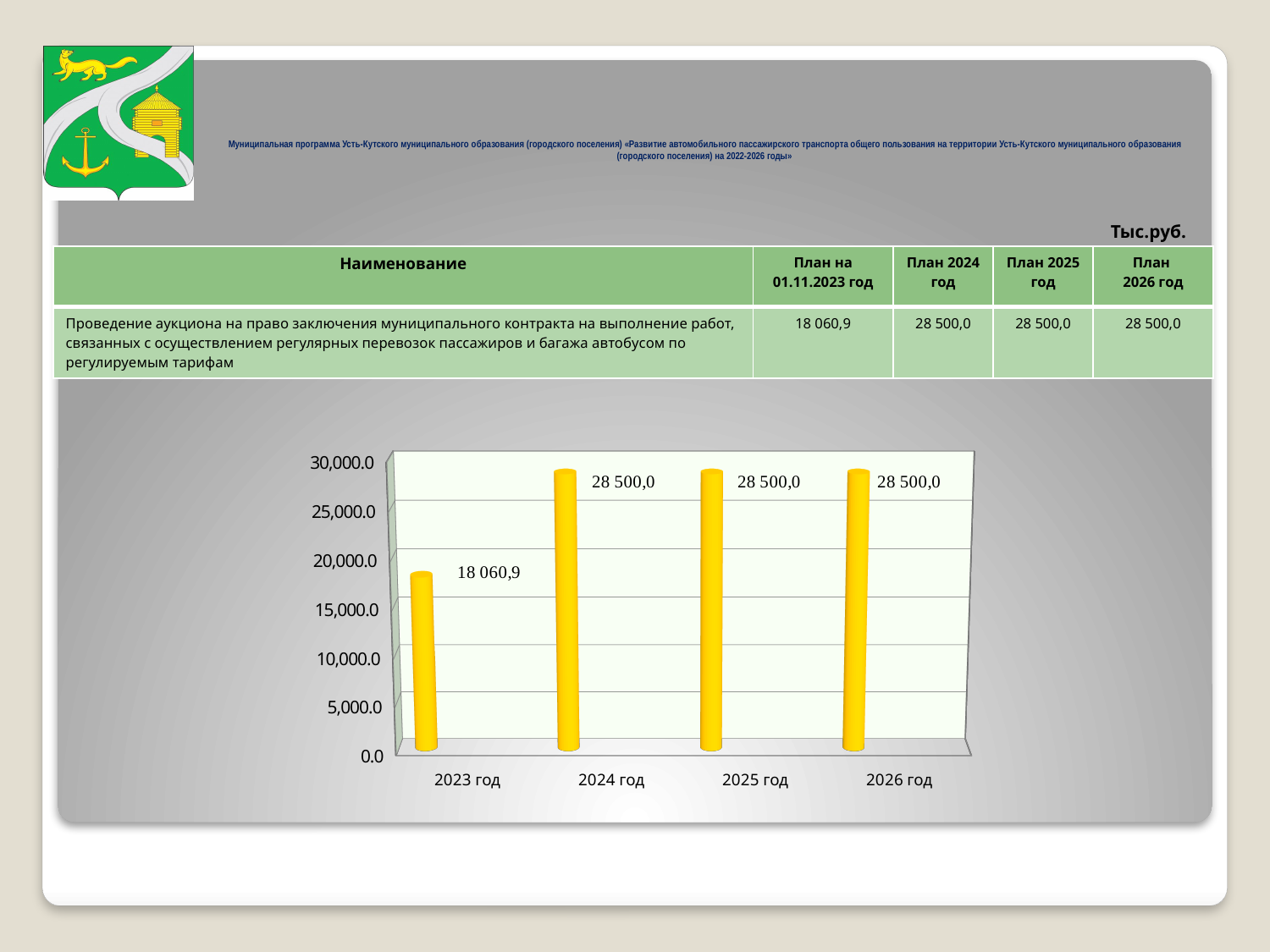
Which year has the lowest value? 2023 год What colour are the bars in the chart? yellow What is the value shown for 2023 год? 18 060,9 Is the value for 2025 год greater or less than 25,000.0? greater What is the value shown for 2026 год? 28 500,0 Is the value for 2023 год greater or less than 20,000.0? less What is the difference between the values for 2024 год and 2023 год? 10 439,1 What is the value shown for 2024 год? 28 500,0 Which is larger, the value for 2023 год or the value for 2025 год? 2025 год Do the values rise or fall from 2023 год to 2024 год? rise How many years are shown on the x axis of the chart? 4 What kind of chart is shown on the slide? bar chart